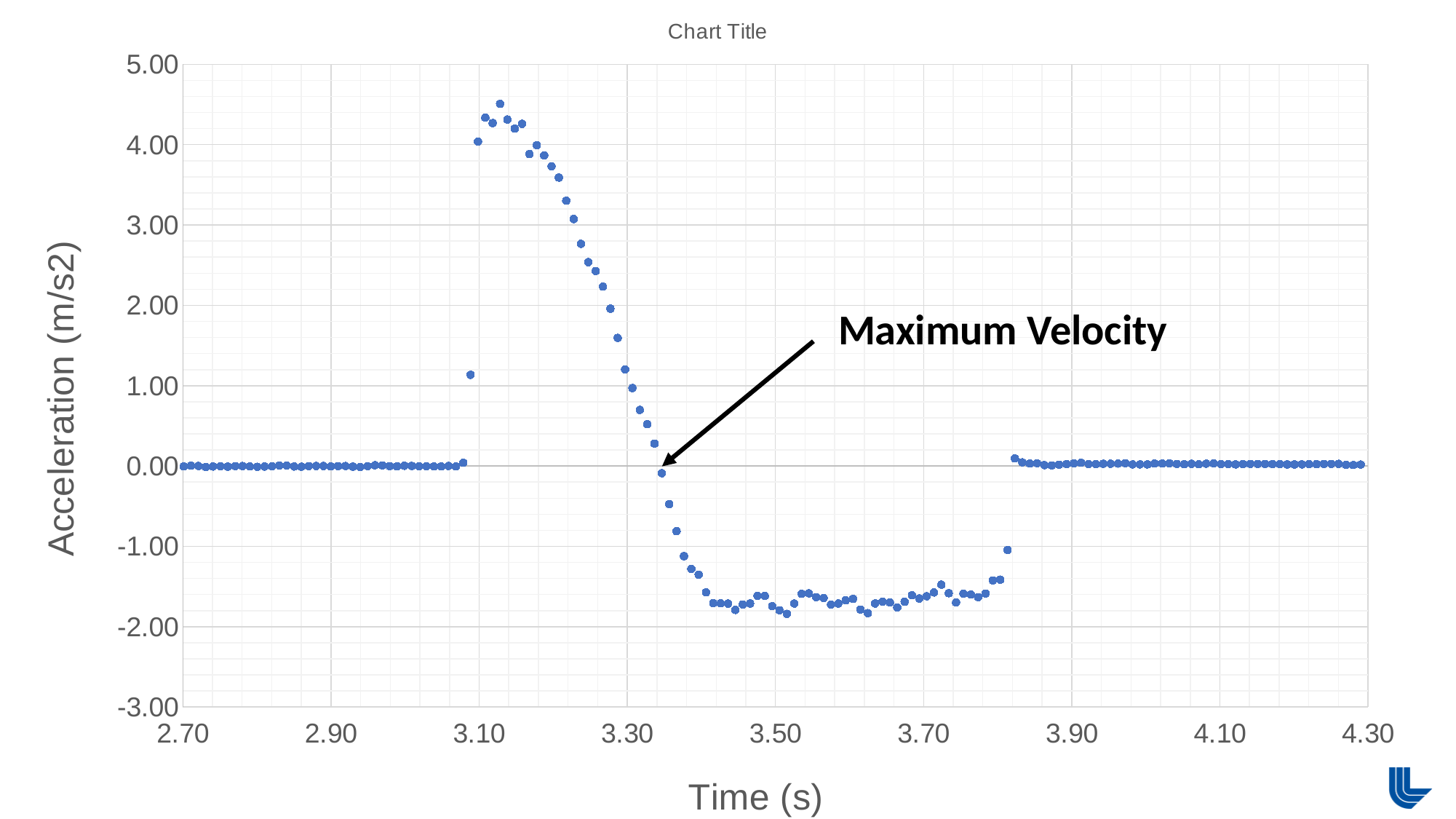
What kind of chart is shown on the slide? scatter chart Is the acceleration value at time 3.50 greater or less than -1.00? less Which is larger, the acceleration value at time 3.60 or at time 4.10? 4.10 Which is larger, the acceleration value at time 3.20 or at time 3.50? 3.20 Between time 3.15 and 3.35, do the acceleration values rise or fall? fall Is the highest acceleration value on the chart greater or less than 4.00? greater Is the acceleration value at time 3.20 greater or less than 2.00? greater What text does the arrow annotation on the chart point with? Maximum Velocity What is the title of the chart? Chart Title